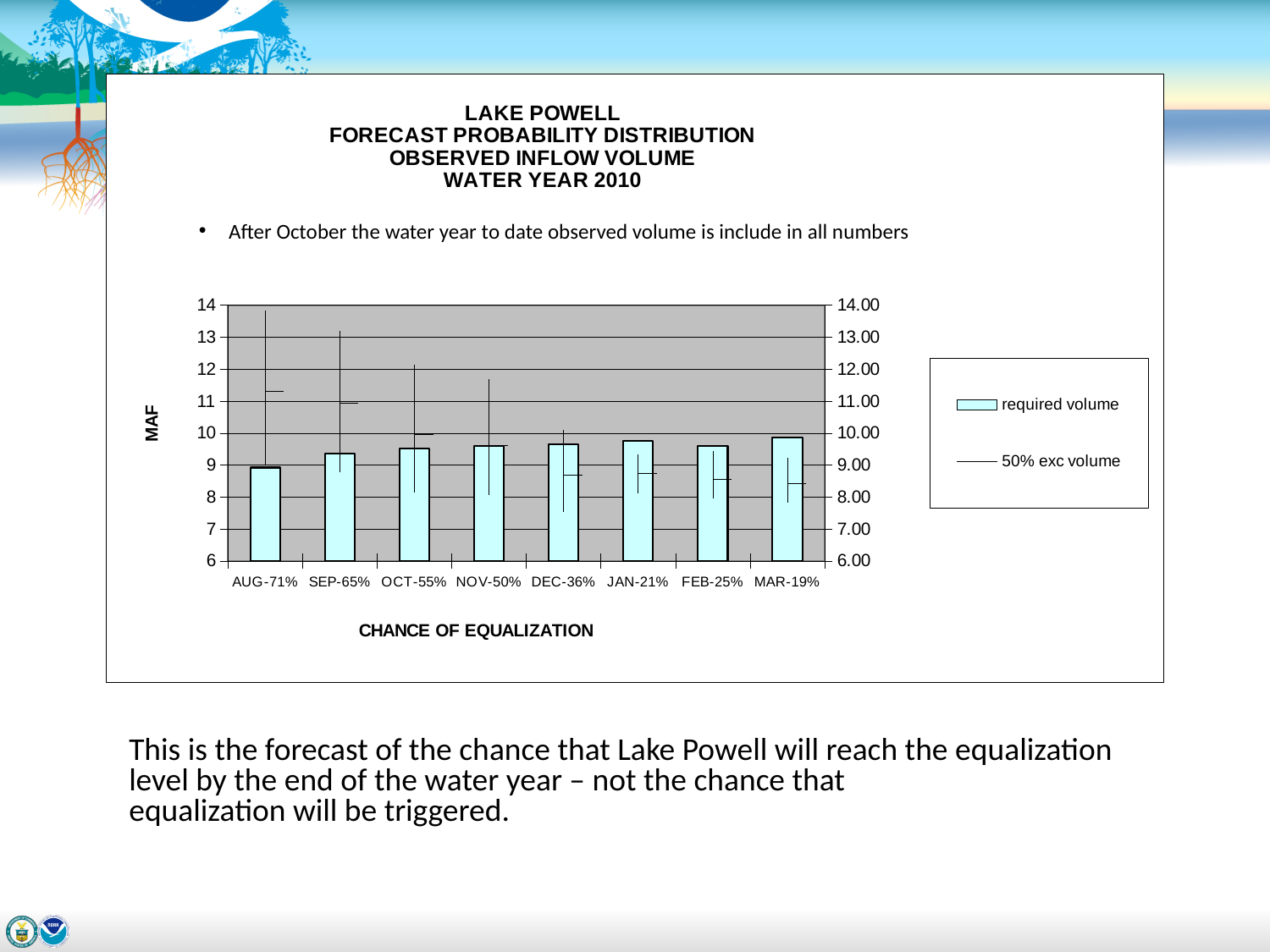
Which has the larger required volume bar, AUG-71% or SEP-65%? SEP-65% How many series does the chart legend list? 2 Do the required volume bars generally rise or fall from AUG-71% to MAR-19%? rise Is the required volume bar for MAR-19% greater or less than 10 MAF? less What is the x axis title of the chart? CHANCE OF EQUALIZATION What is the label of the y axis on the chart? MAF Is the required volume bar for AUG-71% greater or less than 8 MAF? greater Is the required volume bar for JAN-21% greater or less than 11 MAF? less Which category has the lowest required volume bar? AUG-71% How many categories are shown on the x axis of the chart? 8 What kind of chart is shown on the slide? bar chart